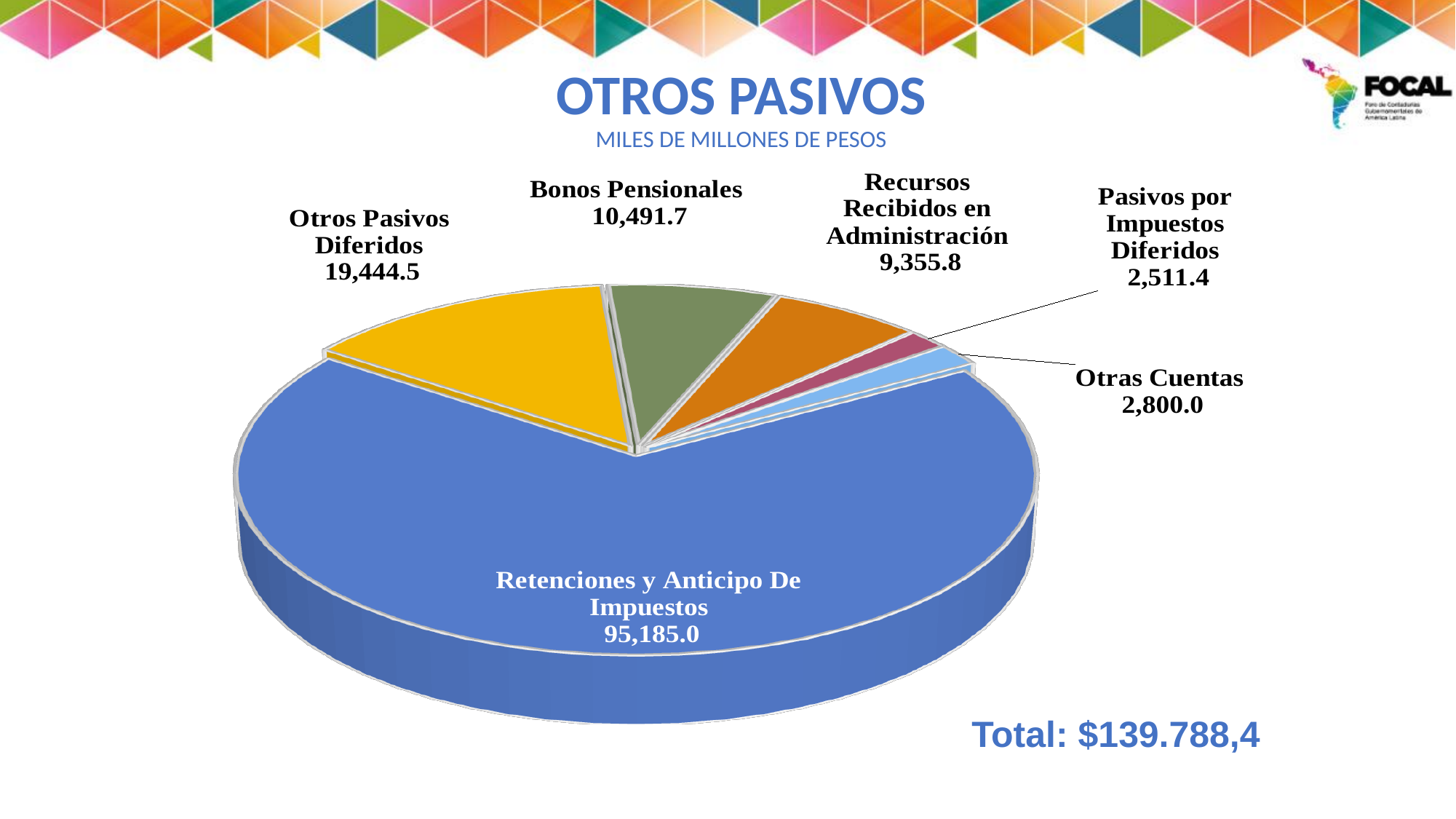
In what units are the values on the slide expressed, according to the subtitle? Miles de millones de pesos How many categories are shown in the pie chart? 6 Which category has the smallest slice of the pie? Pasivos por Impuestos Diferidos What kind of chart is shown on the slide? Pie chart What is the value for Otras Cuentas? 2,800.0 What is the value for Bonos Pensionales? 10,491.7 What is the value for Recursos Recibidos en Administración? 9,355.8 Which category has the largest slice of the pie? Retenciones y Anticipo De Impuestos Which is larger, Otras Cuentas or Pasivos por Impuestos Diferidos? Otras Cuentas What is the difference between Bonos Pensionales and Recursos Recibidos en Administración? 1,135.9 What is the difference between Retenciones y Anticipo De Impuestos and Otros Pasivos Diferidos? 75,740.5 What total is printed on the slide for the chart? $139.788,4